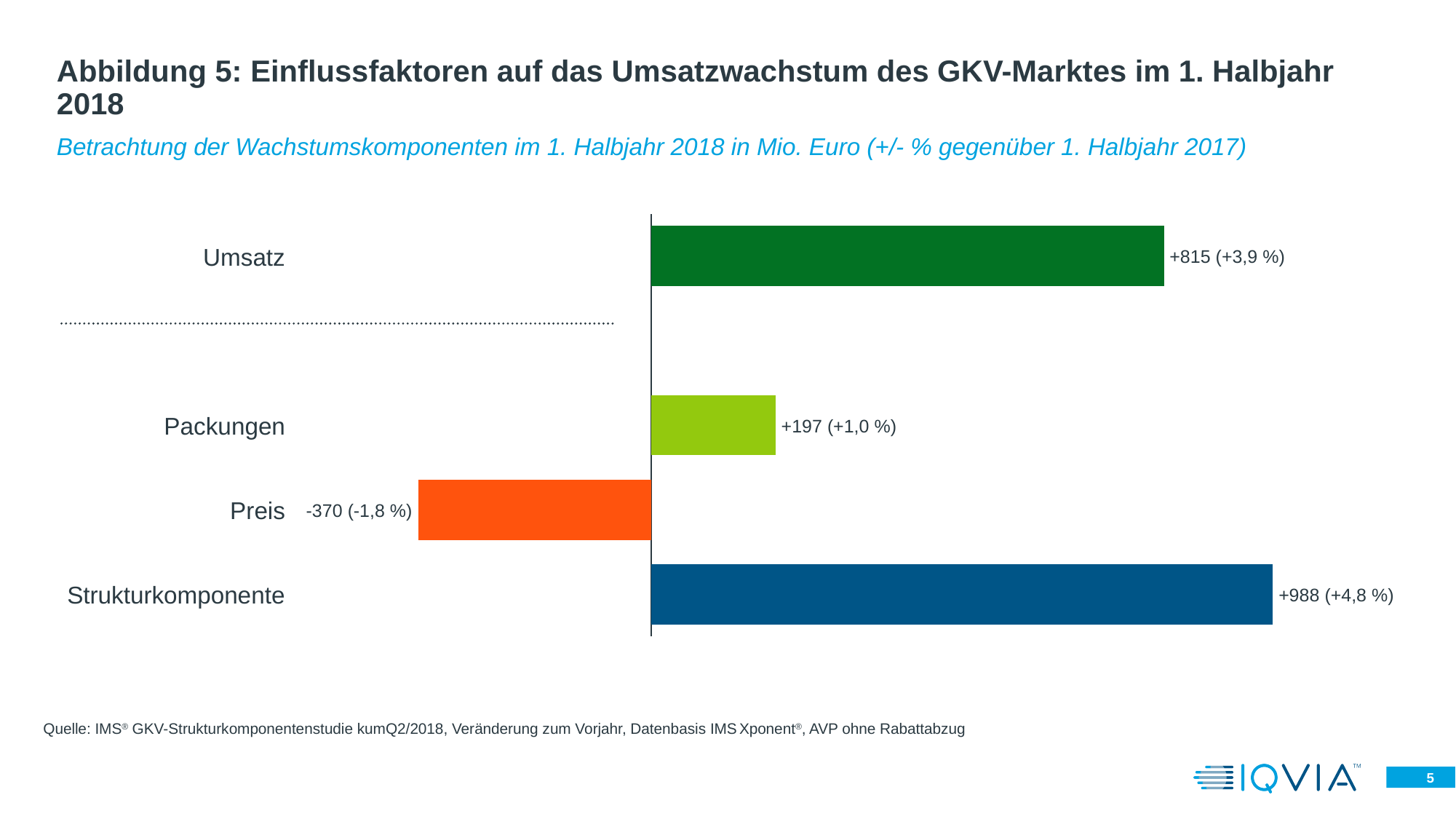
What value is shown for Preis? -370 (-1,8 %) What is the difference in Mio. Euro between Strukturkomponente and Umsatz? 173 Which category has the highest value in Mio. Euro? Strukturkomponente What is the difference in Mio. Euro between Packungen and Preis? 567 What value is shown for Umsatz? +815 (+3,9 %) Which is larger in Mio. Euro, Umsatz or Packungen? Umsatz Which category is shown with a negative value? Preis What value is shown for Packungen? +197 (+1,0 %) Which category has the lowest value in Mio. Euro? Preis What kind of chart is shown on the slide? Bar chart What value is shown for Strukturkomponente? +988 (+4,8 %) How many categories are shown in the chart? 4